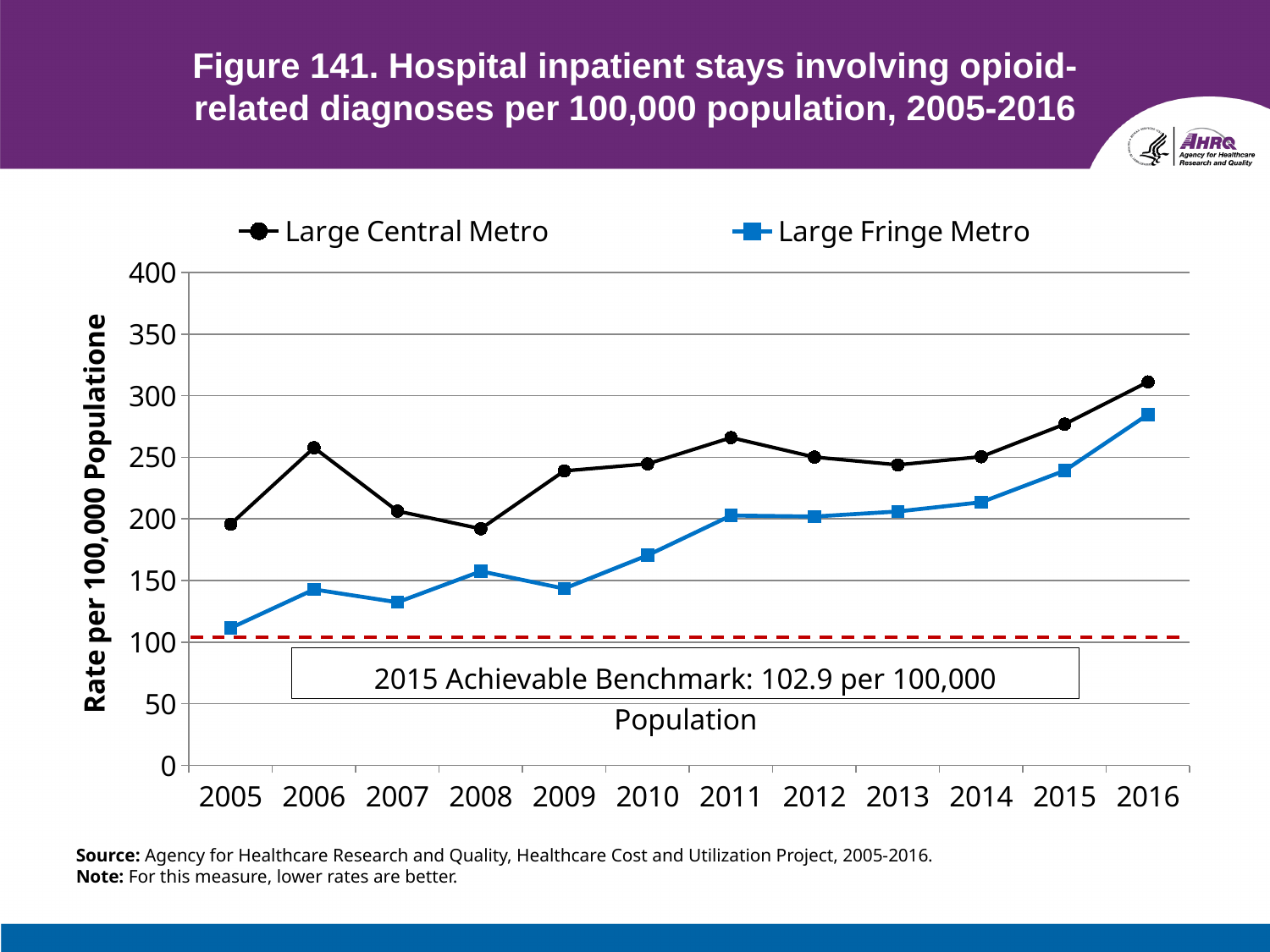
In 2016, which series has the higher rate, Large Central Metro or Large Fringe Metro? Large Central Metro Is the value for Large Fringe Metro in 2005 greater or less than 100? greater Does the Large Fringe Metro rate rise or fall overall from 2005 to 2016? rise In which year is the Large Fringe Metro rate lowest? 2005 How many years are plotted along the x axis? 12 How many series does the legend list? 2 Is the value for Large Fringe Metro in 2016 greater or less than 300? less Is the value for Large Fringe Metro in 2010 greater or less than 200? less What kind of chart is shown on the slide? line chart What is the 2015 achievable benchmark value shown on the chart? 102.9 per 100,000 Population In which year is the Large Central Metro rate highest? 2016